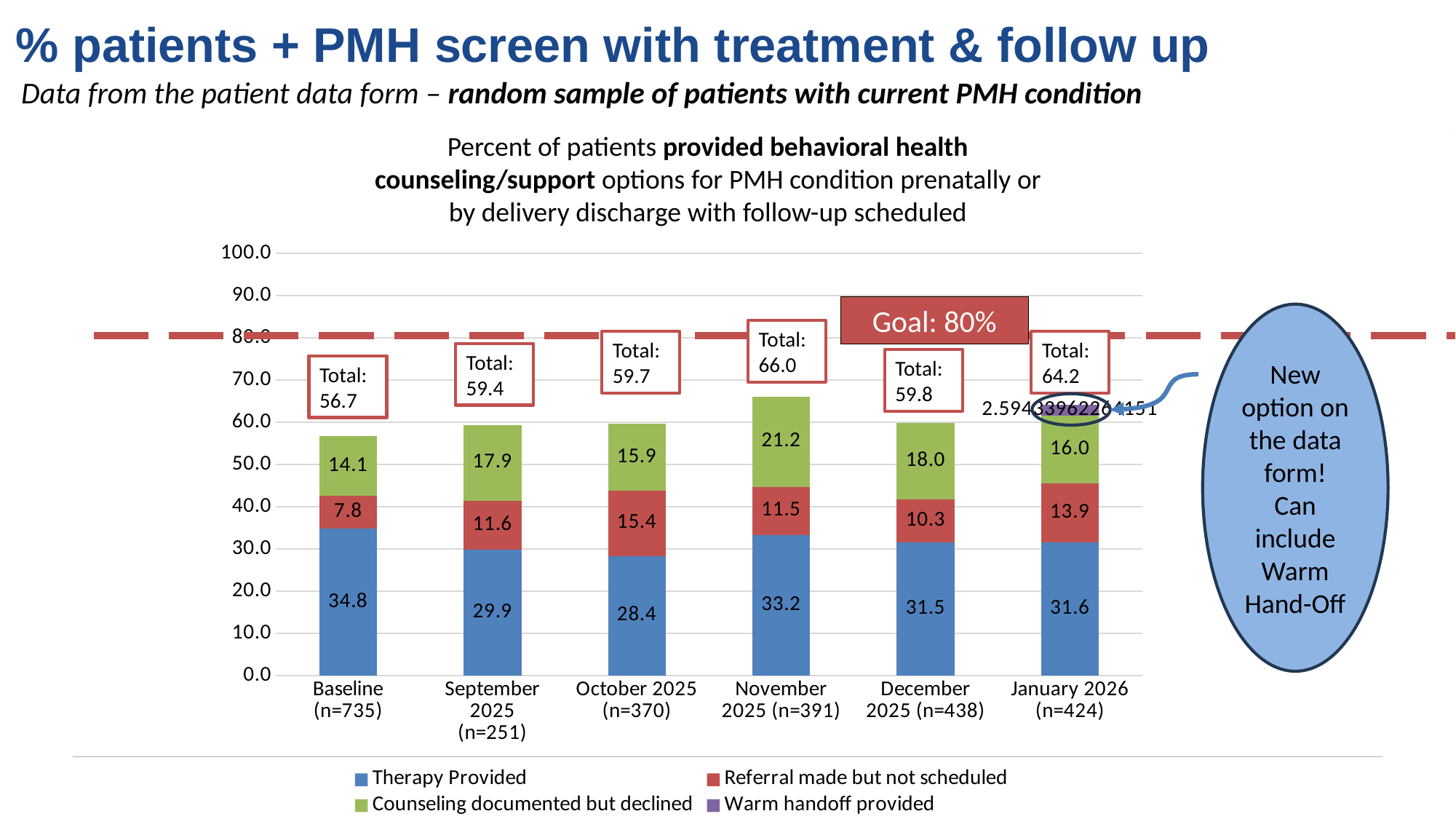
What is the value for Therapy Provided in the Baseline (n=735) bar? 34.8 Which period has the lowest total? Baseline (n=735) What is the difference between the Therapy Provided values for Baseline and October 2025? 6.4 What is the value for Referral made but not scheduled in October 2025 (n=370)? 15.4 Is the total for November 2025 greater or less than 80? less What kind of chart is shown? stacked bar chart How many periods (bars) are shown on the x axis? 6 What is the total of the Baseline (n=735) stacked bar? 56.7 Which period has the highest total? November 2025 (n=391) What is the value for Counseling documented but declined in November 2025 (n=391)? 21.2 How many series does the legend list? 4 Which is larger, the Referral made but not scheduled value for September 2025 or for December 2025? September 2025